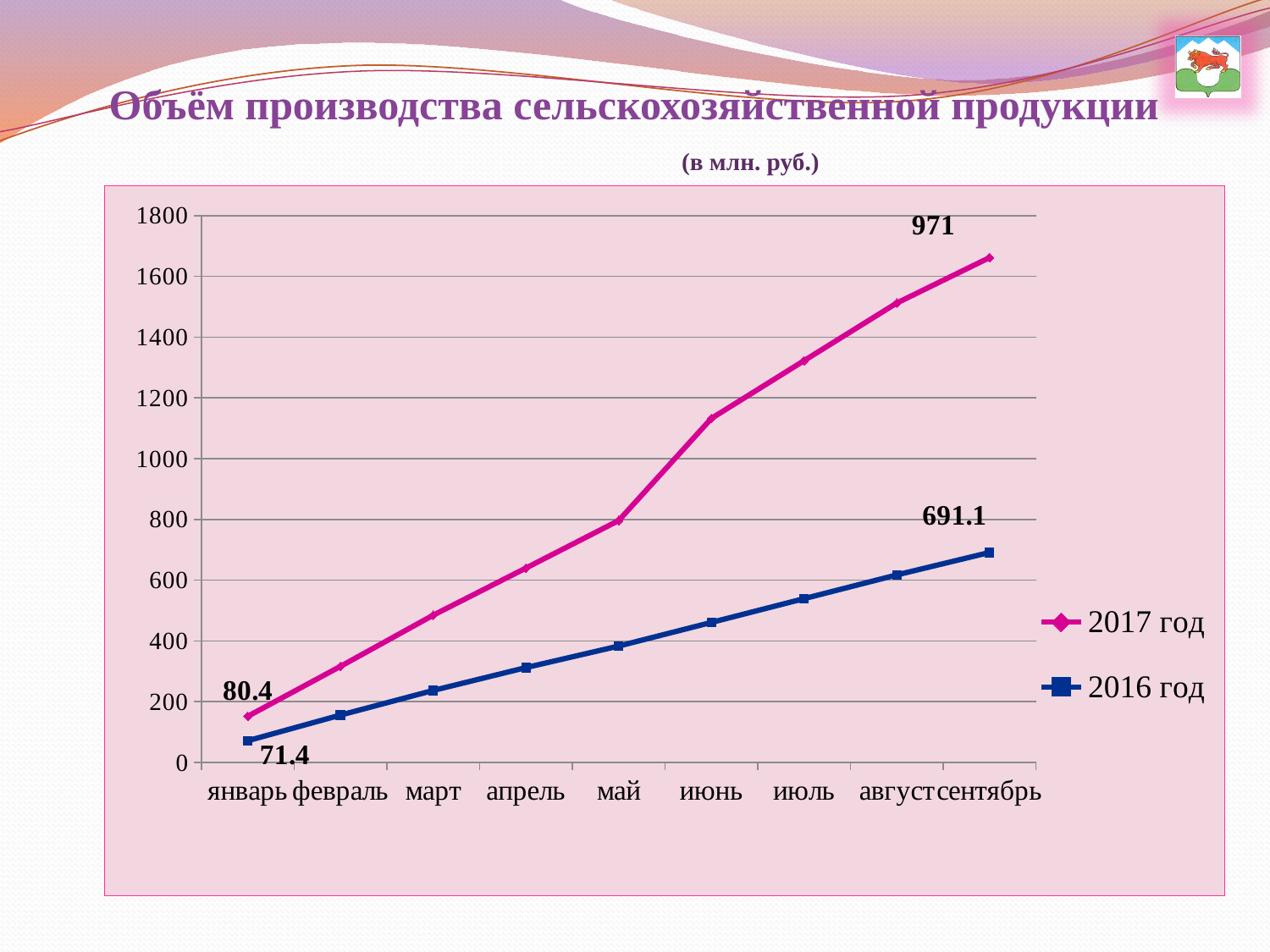
How many series does the legend list? 2 What is the labelled value for сентябрь in the 2016 год series? 691.1 What is the labelled value for январь in the 2017 год series? 80.4 What is the difference between the labelled September and January values of the 2016 год series? 619.7 Do the values of the 2016 год series rise or fall from январь to сентябрь? rise What is the labelled value for сентябрь in the 2017 год series? 971 What is the labelled value for январь in the 2016 год series? 71.4 How many months are shown on the x axis? 9 What kind of chart is shown on the slide? line chart Which series is higher in июль, 2017 год or 2016 год? 2017 год What is the difference between the labelled January values of 2017 год and 2016 год? 9